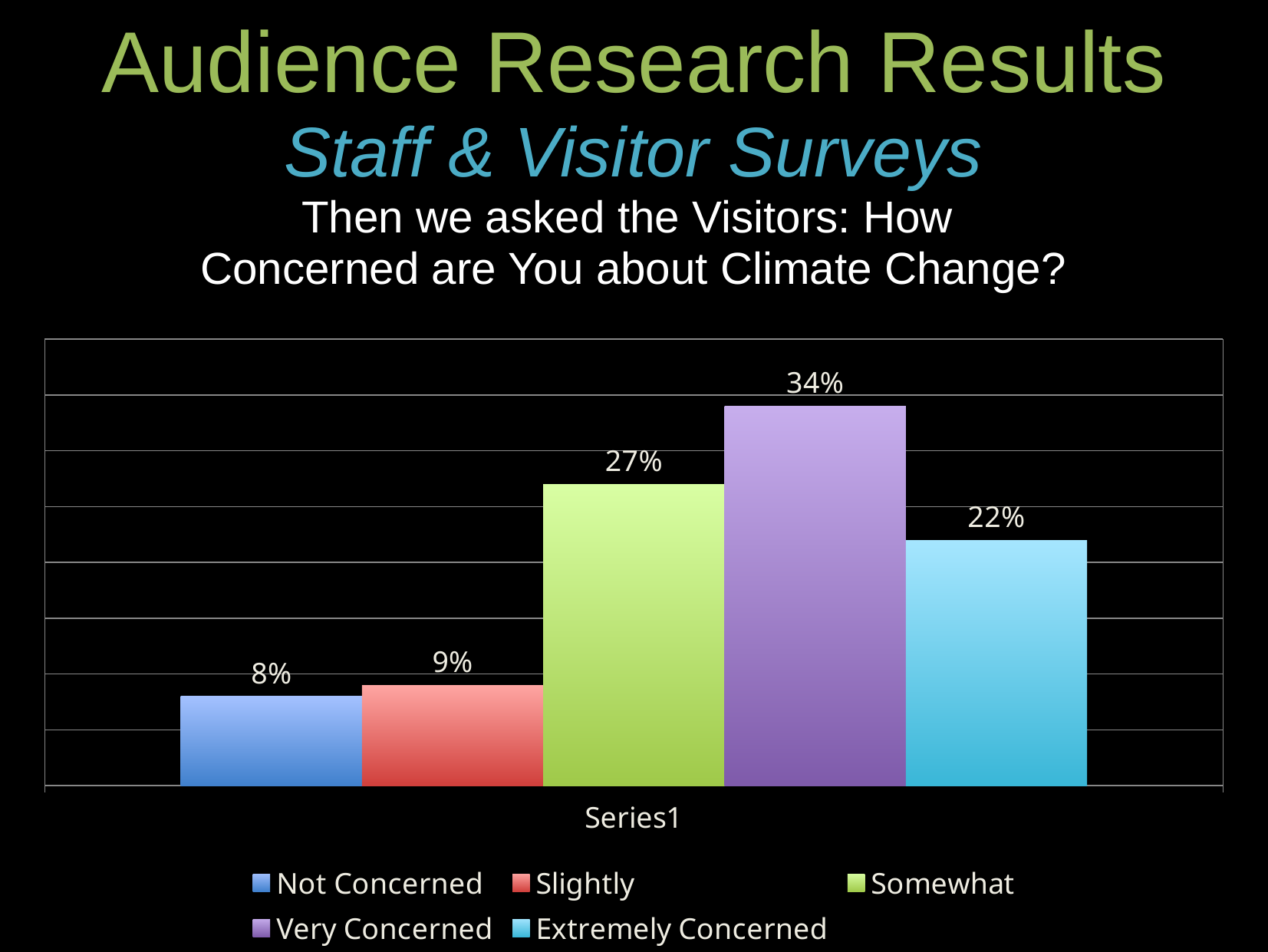
What kind of chart is shown on the slide? Bar chart What is the difference in percentage points between Extremely Concerned and Slightly? 13 How many response categories are shown in the chart? 5 Which response category has the lowest percentage? Not Concerned What percentage of visitors said they were Extremely Concerned? 22% What is the difference in percentage points between Very Concerned and Somewhat? 7 Which response category has the highest percentage? Very Concerned What percentage of visitors said they were Not Concerned? 8% Which is larger, the value for Somewhat or the value for Extremely Concerned? Somewhat How many entries does the legend list? 5 What percentage of visitors said they were Very Concerned about climate change? 34% What colour is the bar for Very Concerned? Purple